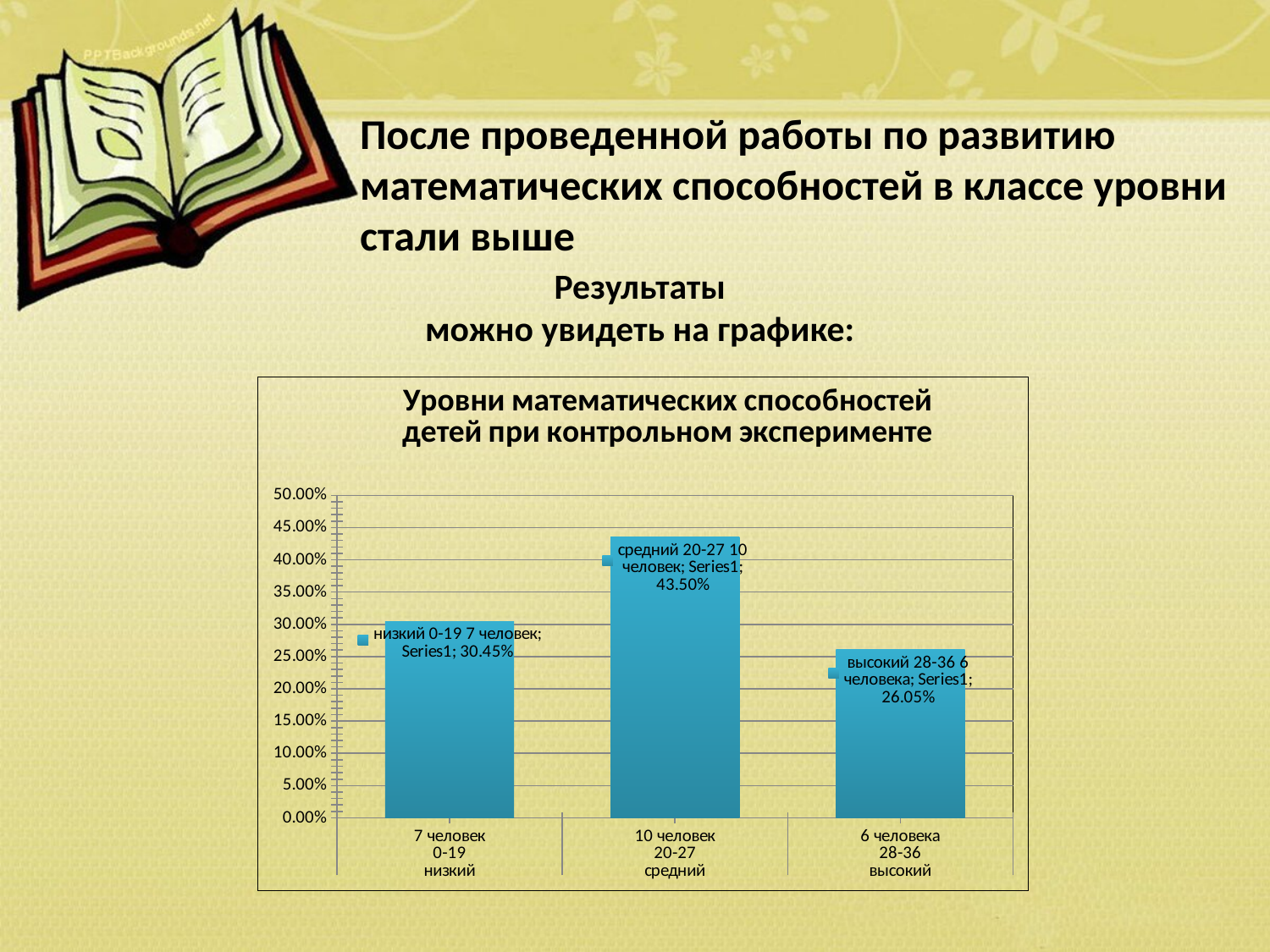
What is the difference between the values for низкий and высокий? 4.40% How many categories are shown in the chart? 3 Which category has the lowest value? высокий What is the difference between the values for средний and низкий? 13.05% What is the value for the высокий (28-36) category? 26.05% What is the value for the средний (20-27) category? 43.50% What is the value for the низкий (0-19) category? 30.45% What is the title of the chart? Уровни математических способностей детей при контрольном эксперименте Is the value for средний greater or less than 40.00%? greater What kind of chart is shown on the slide? bar chart Which category has the highest value? средний Which is larger, the value for низкий or the value for высокий? низкий